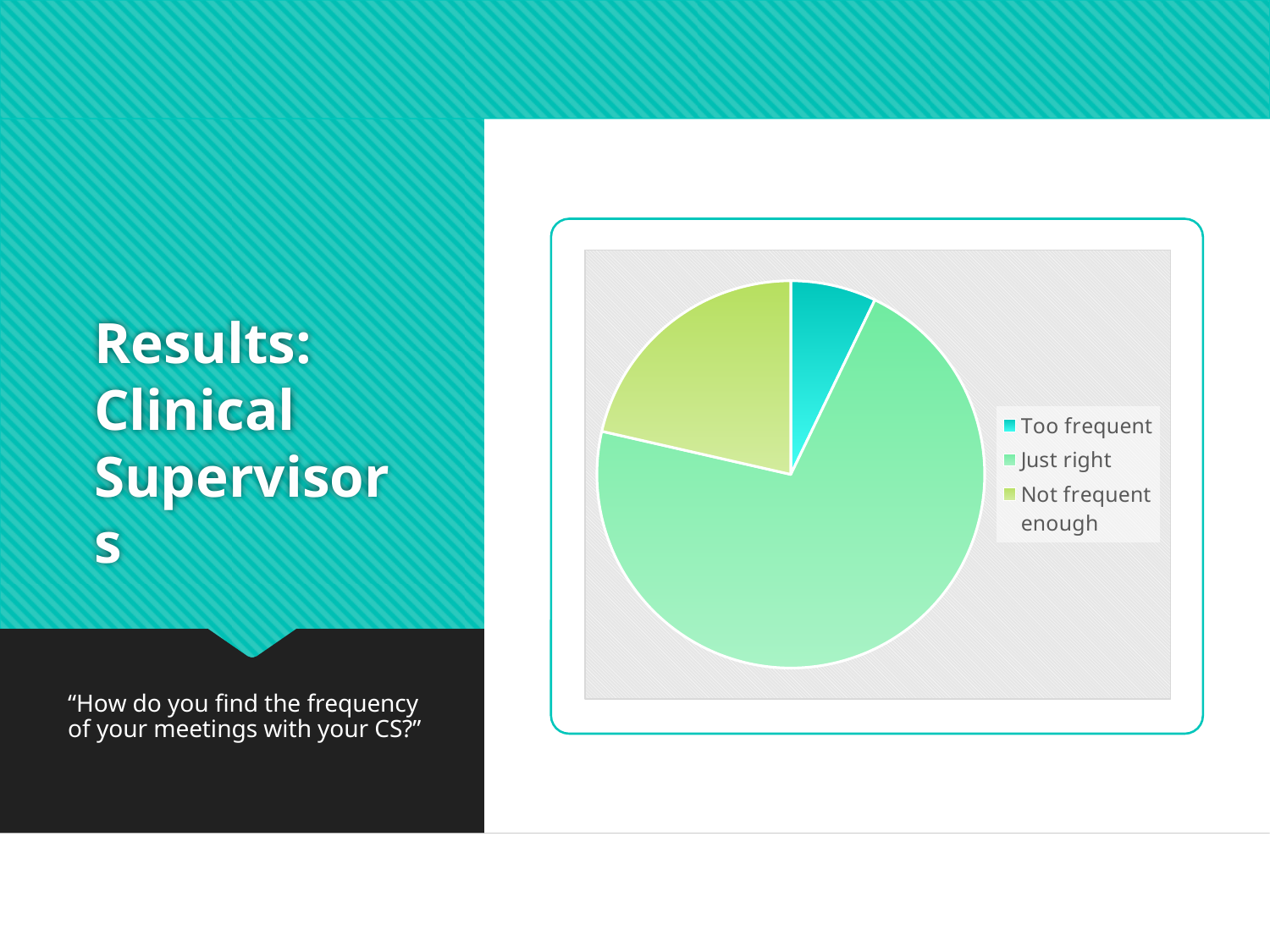
Does the "Just right" slice take up more or less than half of the pie chart? more How many slices does the pie chart have? 3 What are the three categories listed in the legend of the pie chart? Too frequent, Just right, Not frequent enough Which slice is smaller, "Too frequent" or "Just right"? Too frequent Which category has the smallest slice of the pie chart? Too frequent What kind of chart is shown on the slide? pie chart Which slice is larger, "Just right" or "Not frequent enough"? Just right How many entries does the legend of the pie chart list? 3 Which slice is larger, "Too frequent" or "Not frequent enough"? Not frequent enough Which category has the largest slice of the pie chart? Just right Which category is shown in the cyan/teal colour in the pie chart? Too frequent